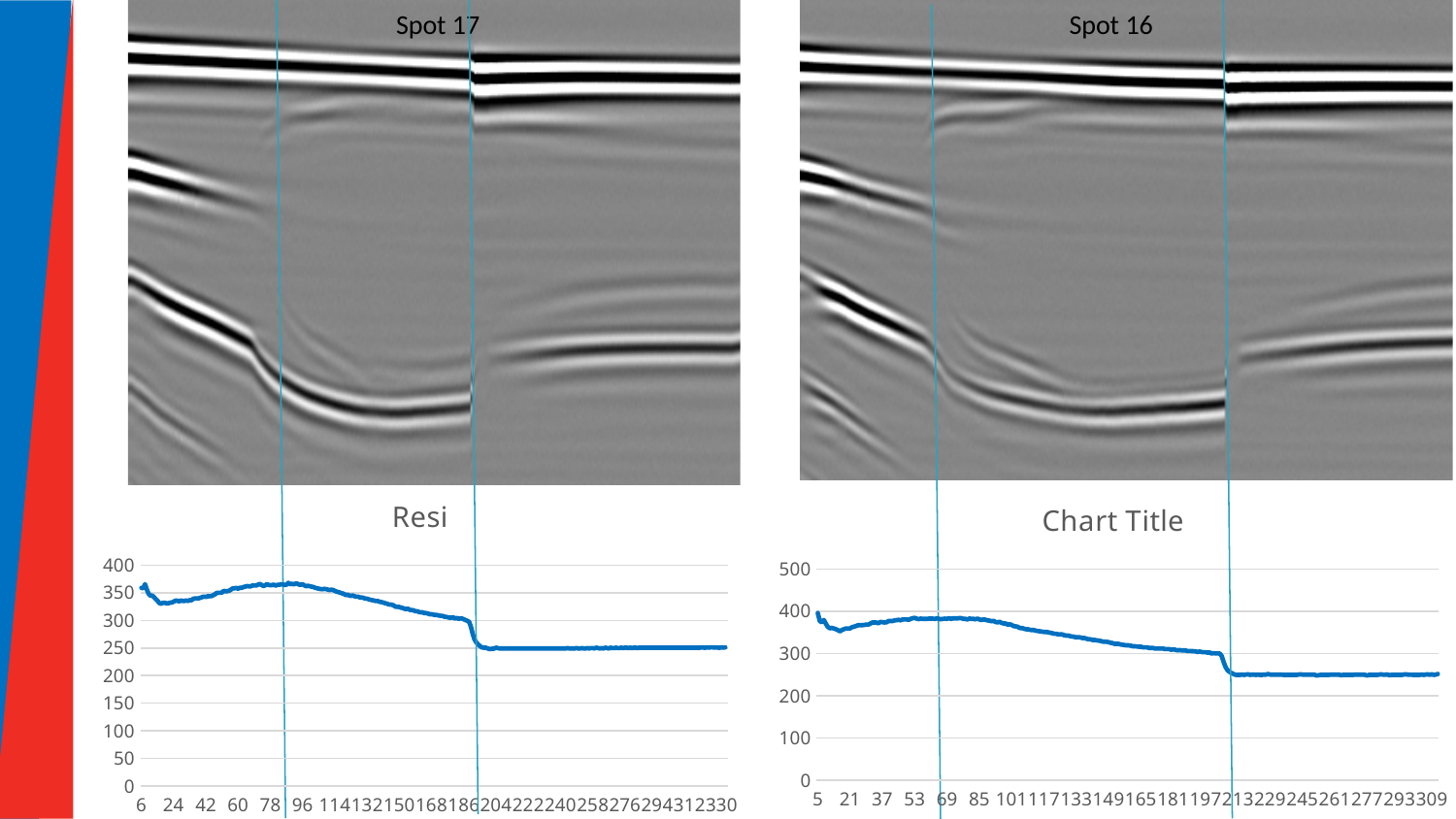
What is the title of the line chart on the right of the slide? Chart Title What kind of chart is the chart titled "Chart Title" on the right? line chart What is the title of the line chart on the left of the slide? Resi What kind of chart is the chart titled "Resi"? line chart In the chart titled "Resi", which is larger: the value at x = 6 or the value at x = 330? x = 6 In the chart titled "Chart Title", do the values overall rise or fall from left to right along the x axis? fall In the chart titled "Resi", do the values overall rise or fall from left to right along the x axis? fall In the chart titled "Chart Title", is the value at x = 85 greater or less than 300? greater In the chart titled "Resi", is the value at x = 6 greater or less than 300? greater In the chart titled "Chart Title", is the value at x = 309 greater or less than 300? less In the chart titled "Chart Title", which is larger: the value at x = 21 or the value at x = 293? x = 21